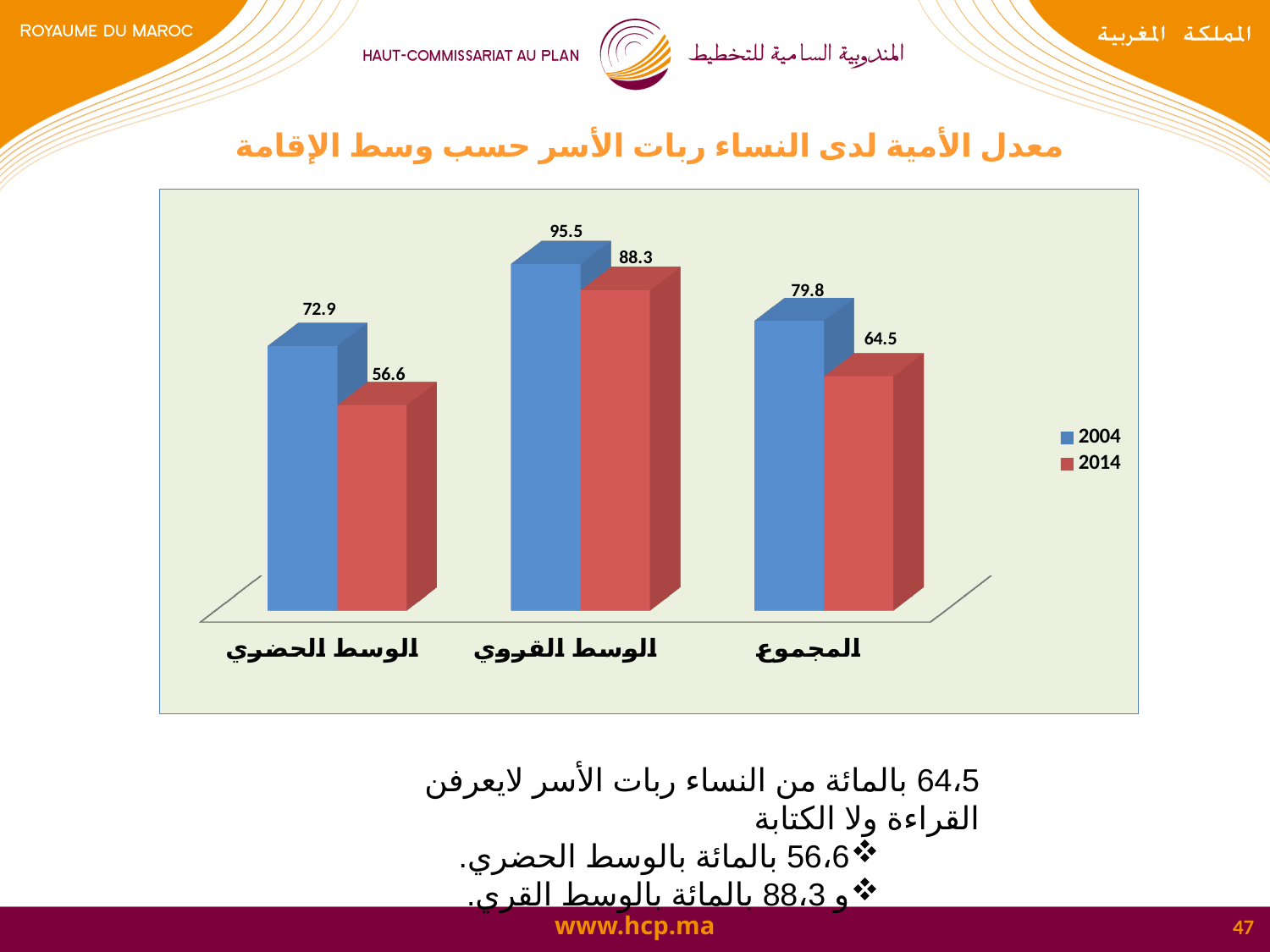
What is the difference between the 2004 and 2014 values for الوسط الحضري? 16.3 What is the value for المجموع in the 2004 series? 79.8 Which is larger for المجموع: the 2004 value or the 2014 value? 2004 What is the value for الوسط الحضري in the 2004 series? 72.9 What is the value for الوسط القروي in the 2014 series? 88.3 How many series does the legend list? 2 How many categories are shown on the x axis? 3 Which category has the highest value in the 2004 series? الوسط القروي What is the value for المجموع in the 2014 series? 64.5 What is the difference between the 2004 and 2014 values for الوسط القروي? 7.2 Which category has the lowest value in the 2014 series? الوسط الحضري What kind of chart is shown on the slide? Bar chart